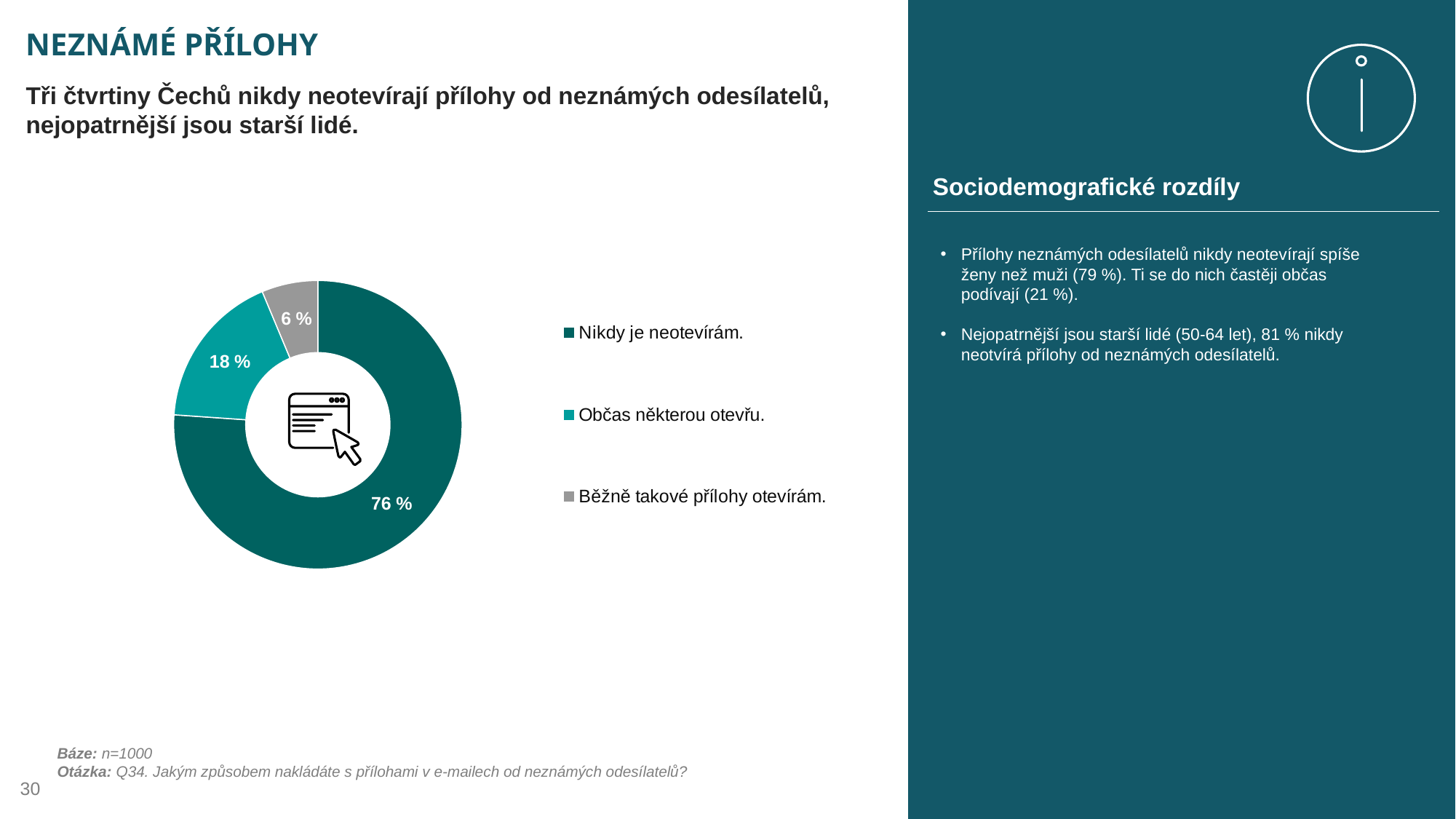
What is the base (sample size) stated for the chart? n=1000 How many categories does the chart show? 3 Which is larger: the share for "Občas některou otevřu." or for "Běžně takové přílohy otevírám."? Občas některou otevřu. What is the combined share of "Občas některou otevřu." and "Běžně takové přílohy otevírám."? 24 % What percentage of respondents answered "Běžně takové přílohy otevírám."? 6 % What kind of chart is shown on the slide? Pie chart (doughnut) What percentage of respondents answered "Občas některou otevřu."? 18 % What percentage of respondents answered "Nikdy je neotevírám."? 76 % Which category has the largest share of the chart? Nikdy je neotevírám. What is the difference in percentage points between "Nikdy je neotevírám." and "Občas některou otevřu."? 58 What colour is the segment for "Běžně takové přílohy otevírám."? Grey Which category has the smallest share of the chart? Běžně takové přílohy otevírám.